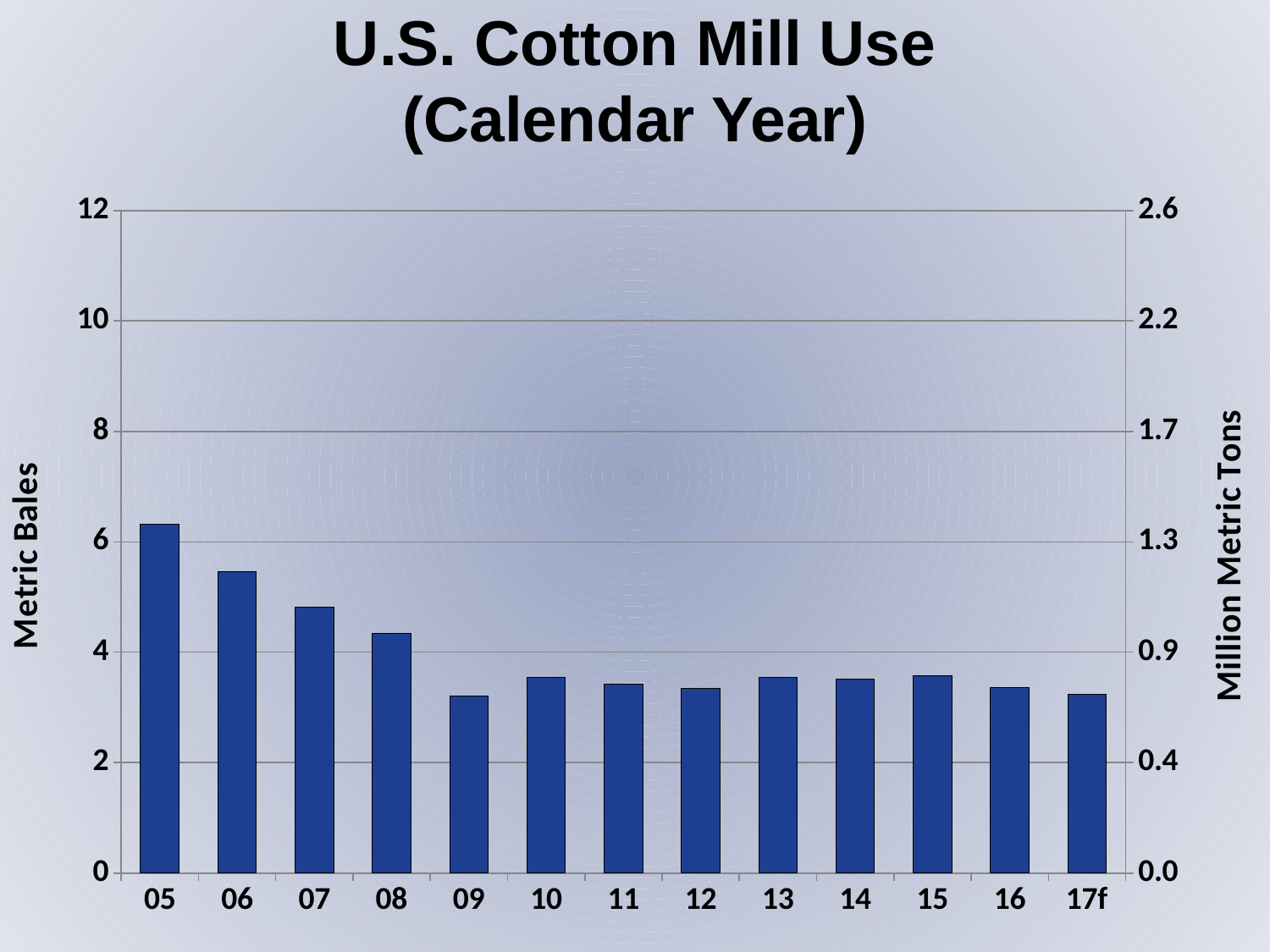
Is the value for 08 greater or less than 4 metric bales? greater Is the value for 09 greater or less than 4 metric bales? less Which is larger, the value for 06 or the value for 10? 06 Is the value for 05 greater or less than 6 metric bales? greater Which is larger, the value for 07 or the value for 08? 07 Which year has the highest U.S. cotton mill use? 05 Do the values generally rise or fall from 05 to 09? Fall What is the label on the right-hand vertical axis? Million Metric Tons How many years (bars) are plotted on the chart? 13 What kind of chart is shown on the slide? Bar chart